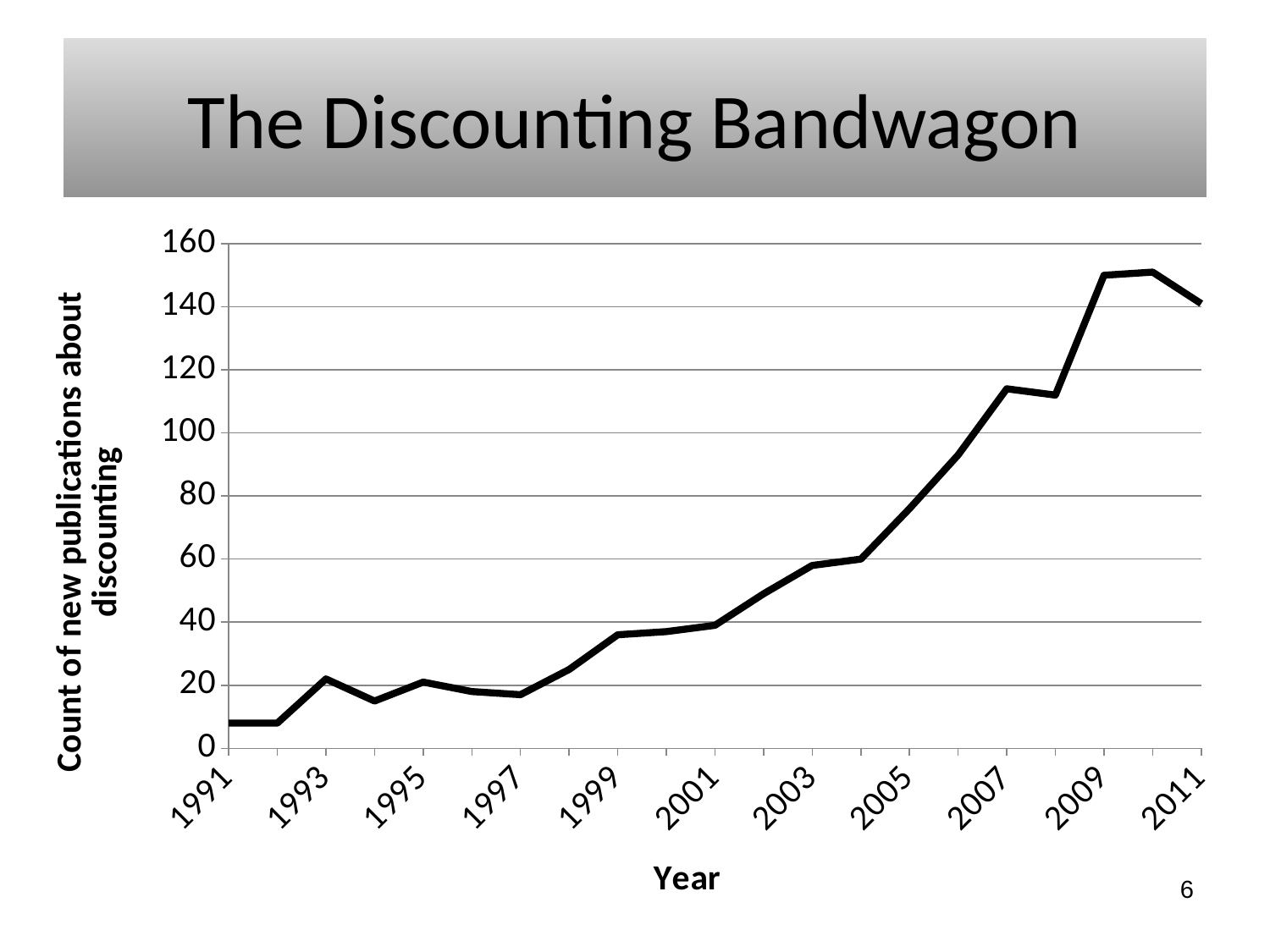
Which year has the larger value, 1995 or 2005? 2005 What is the title of the slide containing the chart? The Discounting Bandwagon Overall, do the values rise or fall from 1991 to 2011? rise Which year has the larger value, 2001 or 2011? 2011 Is the value for 2011 greater or less than 120? greater Is the value for 2003 greater or less than 80? less Is the value for 1999 greater or less than 20? greater What is the label on the vertical axis of the chart? Count of new publications about discounting What kind of chart is shown on the slide? line chart